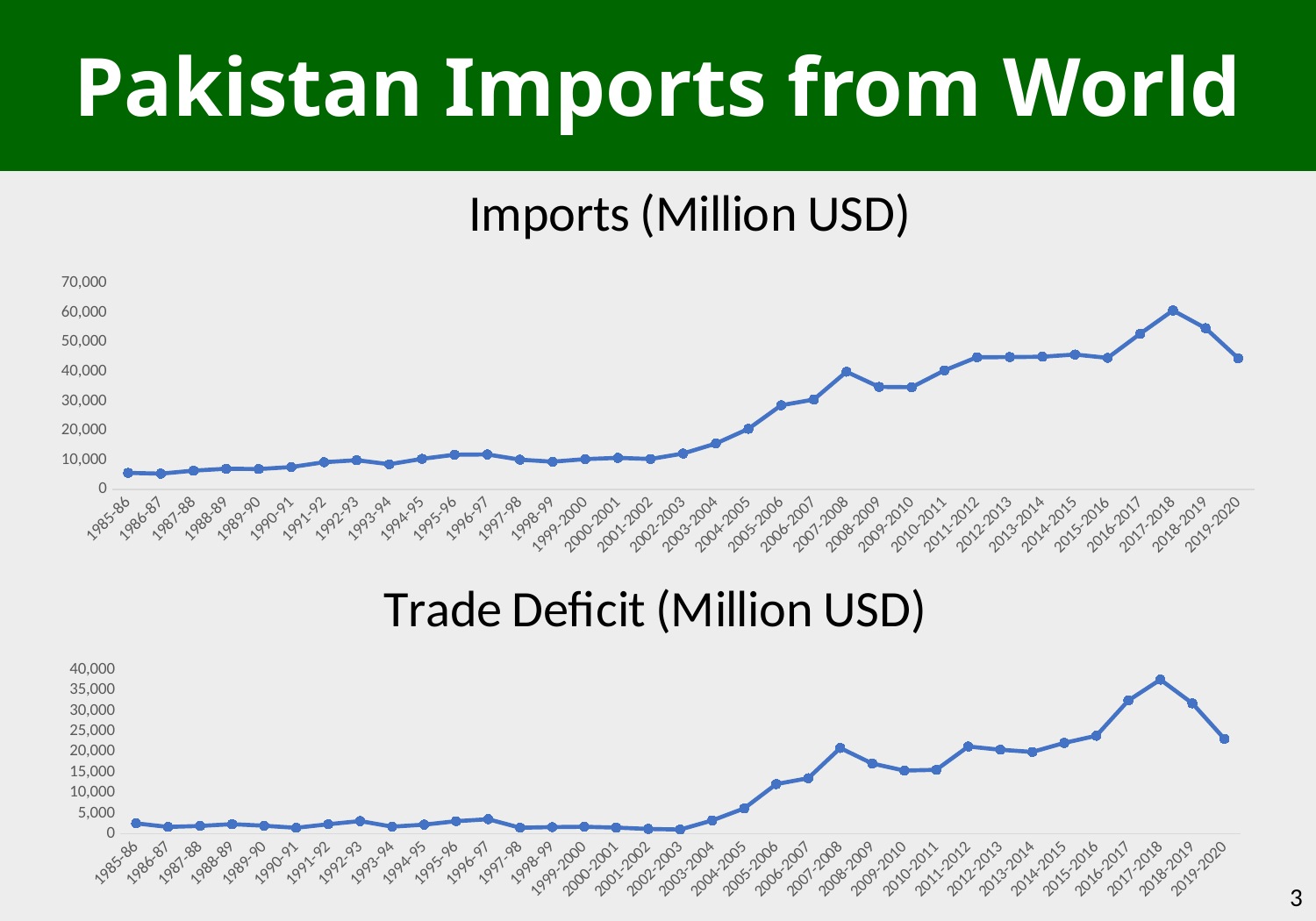
In the 'Trade Deficit (Million USD)' chart, is the value for 2005-2006 greater or less than 10,000? greater How many years are plotted on the 'Imports (Million USD)' chart? 35 In the 'Trade Deficit (Million USD)' chart, which year has the highest value? 2017-2018 In the 'Imports (Million USD)' chart, is the value for 2017-2018 greater or less than 50,000? greater What type of chart is the 'Imports (Million USD)' chart? Line chart In the 'Trade Deficit (Million USD)' chart, is the value for 2017-2018 greater or less than 30,000? greater In the 'Imports (Million USD)' chart, which year has the highest value? 2017-2018 In the 'Imports (Million USD)' chart, which year has the larger value, 2017-2018 or 2019-2020? 2017-2018 In the 'Imports (Million USD)' chart, do the values generally rise or fall from 1985-86 to 2017-2018? Rise In the 'Trade Deficit (Million USD)' chart, which year has the larger value, 2007-2008 or 2009-2010? 2007-2008